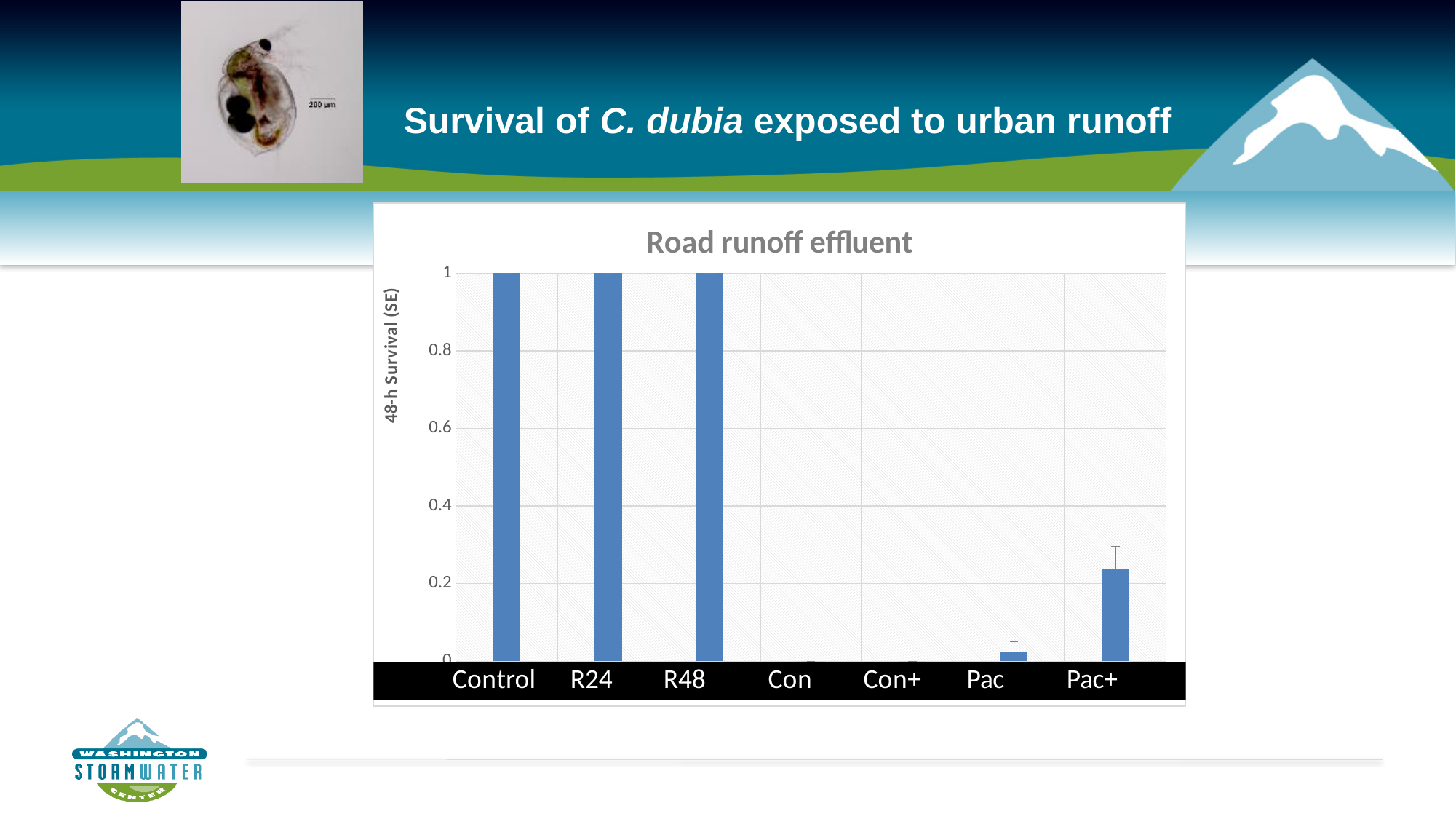
Which has the larger 48-h survival value, R48 or Con? R48 How many categories are shown on the x axis of the chart? 7 Is the value for Pac+ greater or less than 0.4? less What kind of chart is shown on the slide? bar chart What is the label on the vertical axis of the chart? 48-h Survival (SE) What is the 48-h survival value for R24? 1 Is the value for Pac greater or less than 0.2? less Which has the larger 48-h survival value, Control or Pac+? Control What is the title of the chart? Road runoff effluent Which has the larger 48-h survival value, Pac or Pac+? Pac+ What is the 48-h survival value for Control? 1 What is the 48-h survival value for R48? 1